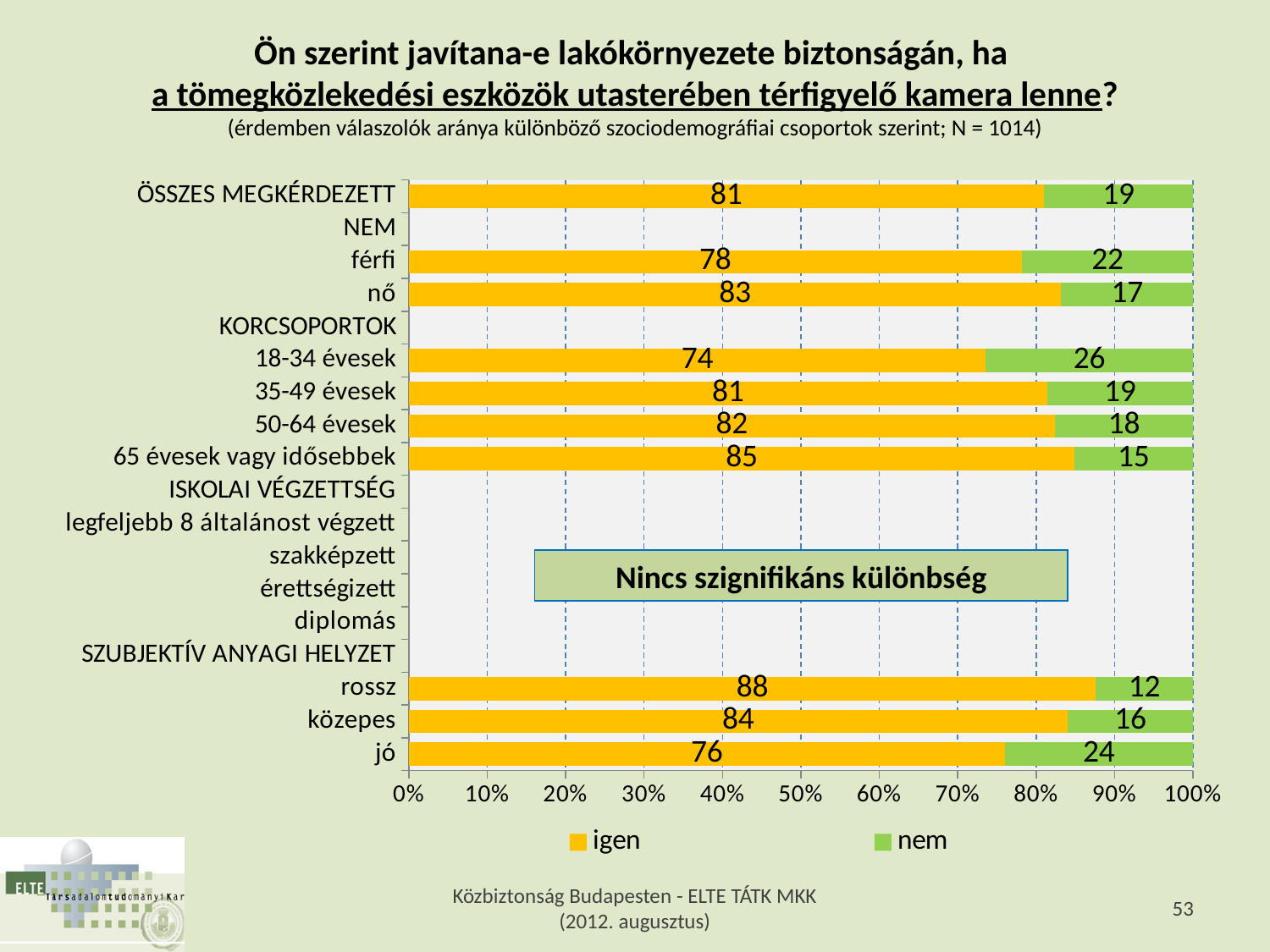
Which category has the lowest "igen" value? 18-34 évesek Which category has the highest "igen" value? rossz What kind of chart is shown on the slide? Stacked bar chart What is the "igen" value for ÖSSZES MEGKÉRDEZETT? 81 What is the difference between the "igen" values for nő and férfi? 5 What text is shown in the box placed over the ISKOLAI VÉGZETTSÉG categories? Nincs szignifikáns különbség What is the "nem" value for 18-34 évesek? 26 What is the total of the stacked bar for 50-64 évesek? 100 Which has a larger "nem" value, jó or közepes? jó How many series does the legend list? 2 Which colour represents the "nem" series? Green What is the "igen" value for 65 évesek vagy idősebbek? 85